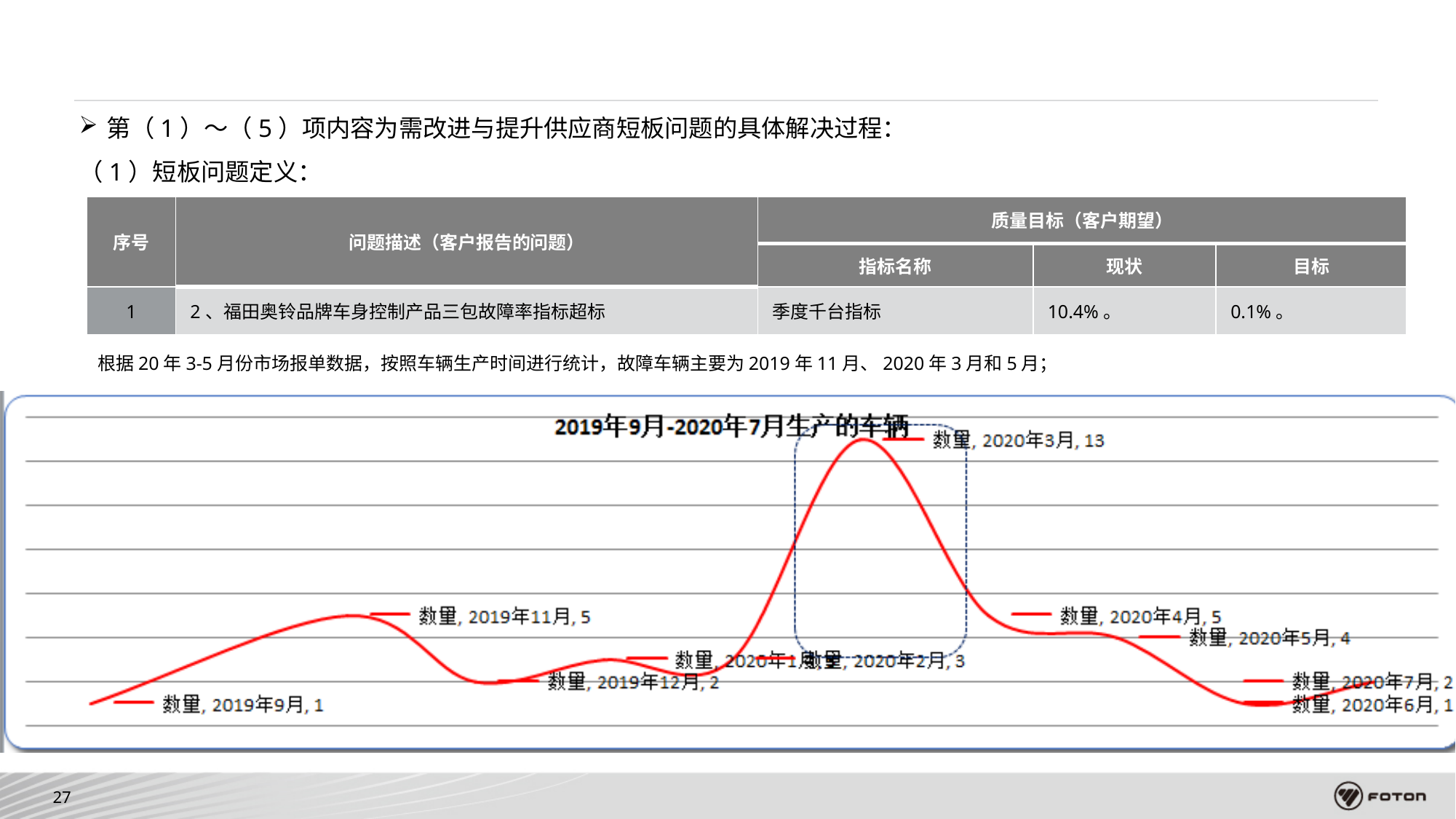
What is the 数量 value for 2019年11月? 5 What is the 数量 value for 2020年3月? 13 What is the difference between the 数量 values for 2020年3月 and 2020年4月? 8 Which is larger, the 数量 value for 2019年11月 or for 2019年12月? 2019年11月 Which month has the highest 数量 value? 2020年3月 What type of chart is shown on the slide? line chart What is the 数量 value for 2019年9月? 1 What is the name of the data series labelled on the chart? 数量 What is the 数量 value for 2020年5月? 4 What is the 数量 value for 2020年7月? 2 What is the title of the chart? 2019年9月-2020年7月生产的车辆 Do the 数量 values rise or fall from 2020年3月 to 2020年6月? fall